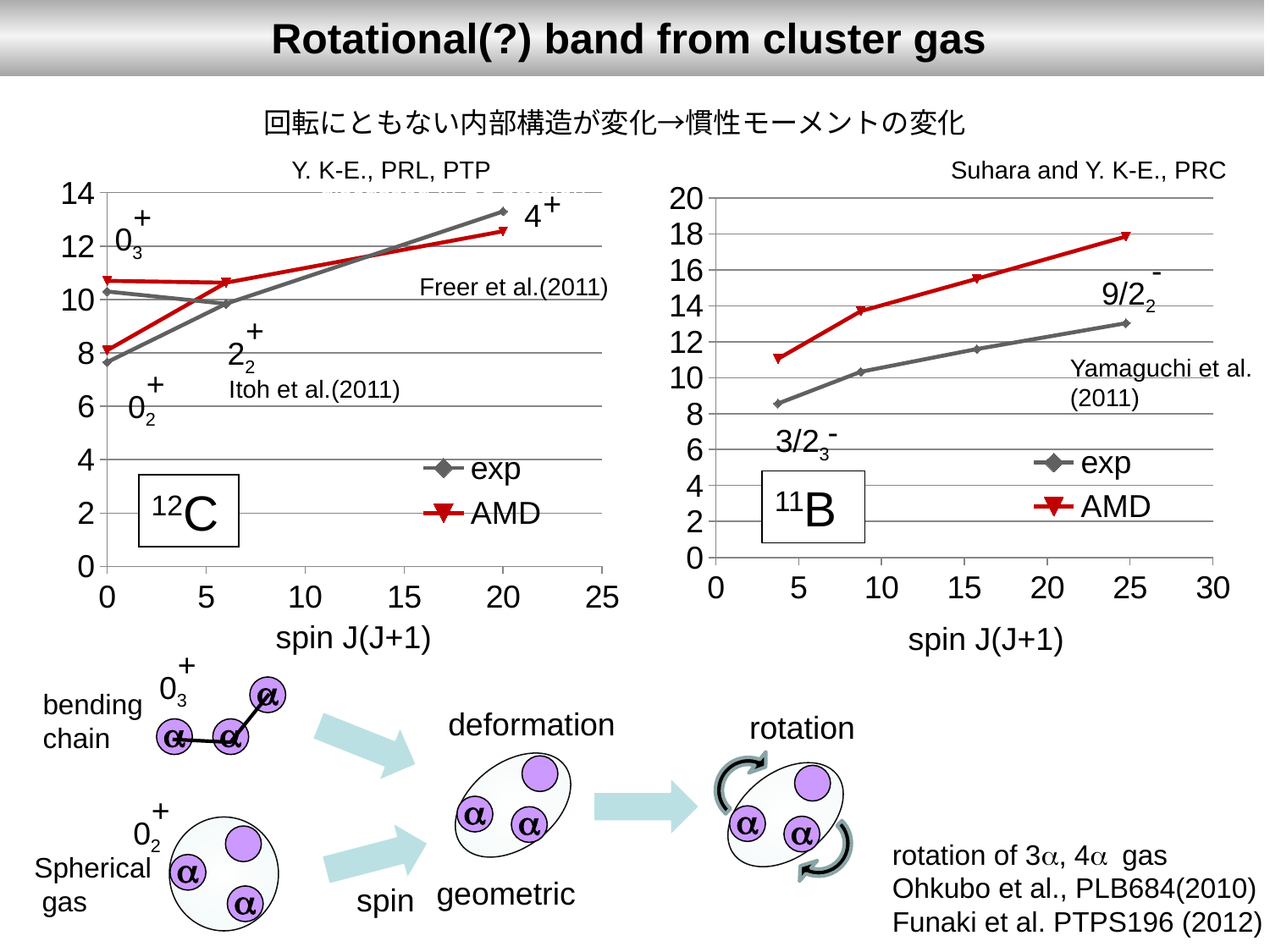
In the 11B chart on the right, is the AMD value at the highest spin J(J+1) (around 25) greater or less than 16? greater In the 11B chart on the right, is the exp value at the highest spin J(J+1) (around 25) greater or less than 14? less In the 12C chart on the left, is the exp value for the 0_2+ state at spin J(J+1) = 0 greater or less than 10? less What kind of chart is the 12C chart on the left of the slide? line chart How many series does the legend of the 11B chart on the right list? 2 In the 11B chart on the right, do the AMD values rise or fall as spin J(J+1) increases? rise In the 11B chart on the right, how many data points does the exp series have? 4 What are the two series named in the legend of the 12C chart on the left? exp and AMD In the 12C chart on the left, which series is higher at spin J(J+1) = 20, exp or AMD? exp In the 11B chart on the right, which series is higher at spin J(J+1) around 25, exp or AMD? AMD What is the x-axis label of the 11B chart on the right? spin J(J+1)